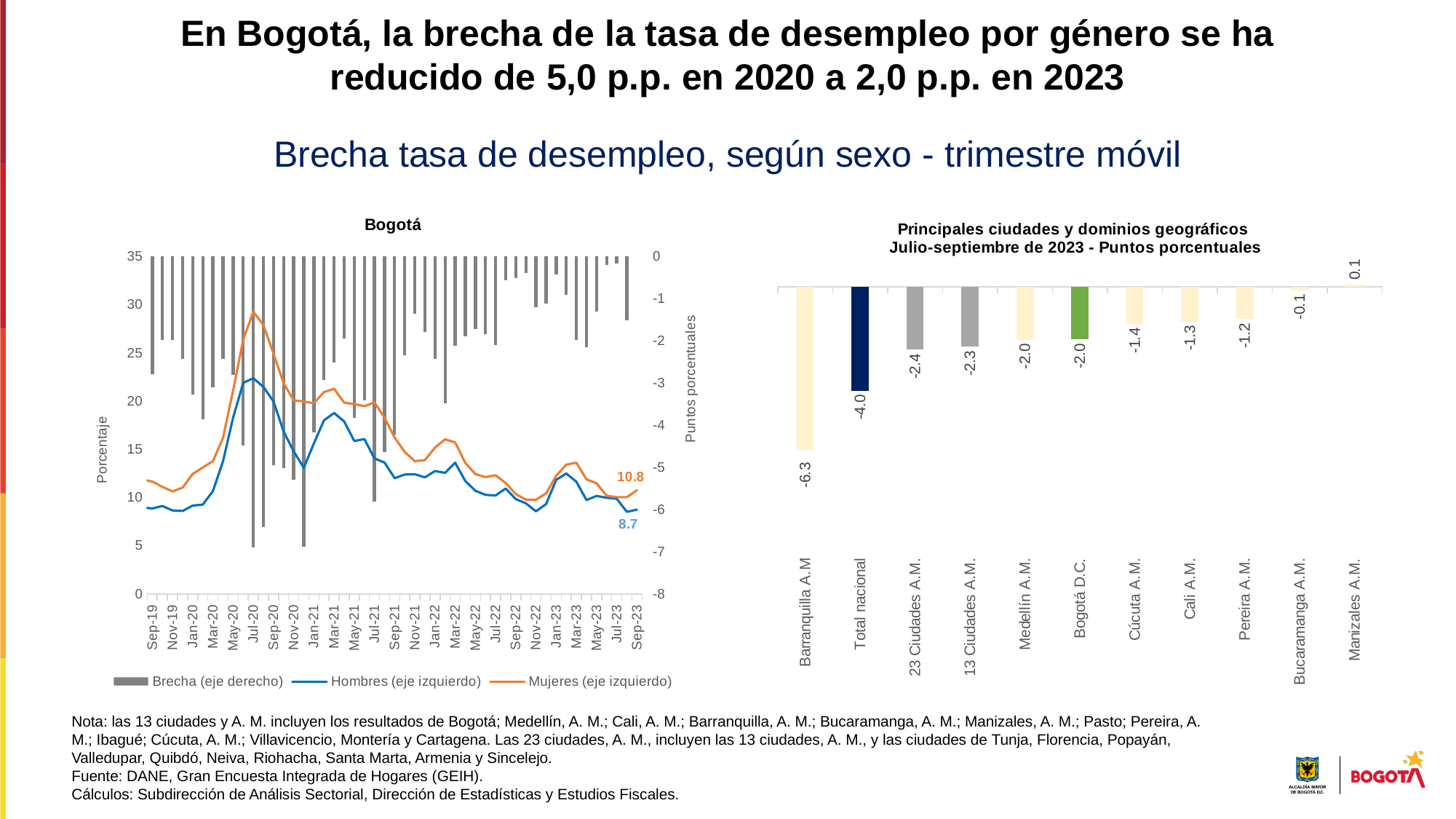
What kind of chart is the 'Principales ciudades y dominios geográficos' chart? Bar chart In the 'Bogotá' chart, what is the labelled value for Hombres at Sep-23? 8.7 In the 'Principales ciudades y dominios geográficos' chart, what is the value for Bogotá D.C.? -2.0 In the 'Principales ciudades y dominios geográficos' chart, what is the difference between the values for 23 Ciudades A.M. and 13 Ciudades A.M.? 0.1 In the 'Principales ciudades y dominios geográficos' chart, which category has the lowest value? Barranquilla A.M In the 'Principales ciudades y dominios geográficos' chart, which category has the highest value? Manizales A.M. How many categories are shown in the 'Principales ciudades y dominios geográficos' chart? 11 In the 'Principales ciudades y dominios geográficos' chart, what is the value for Barranquilla A.M? -6.3 In the 'Bogotá' chart, what is the labelled value for Mujeres at Sep-23? 10.8 In the 'Principales ciudades y dominios geográficos' chart, which has the larger value, Cúcuta A.M. or Cali A.M.? Cali A.M. In the 'Principales ciudades y dominios geográficos' chart, what is the value for Total nacional? -4.0 How many series does the legend of the 'Bogotá' chart list? 3